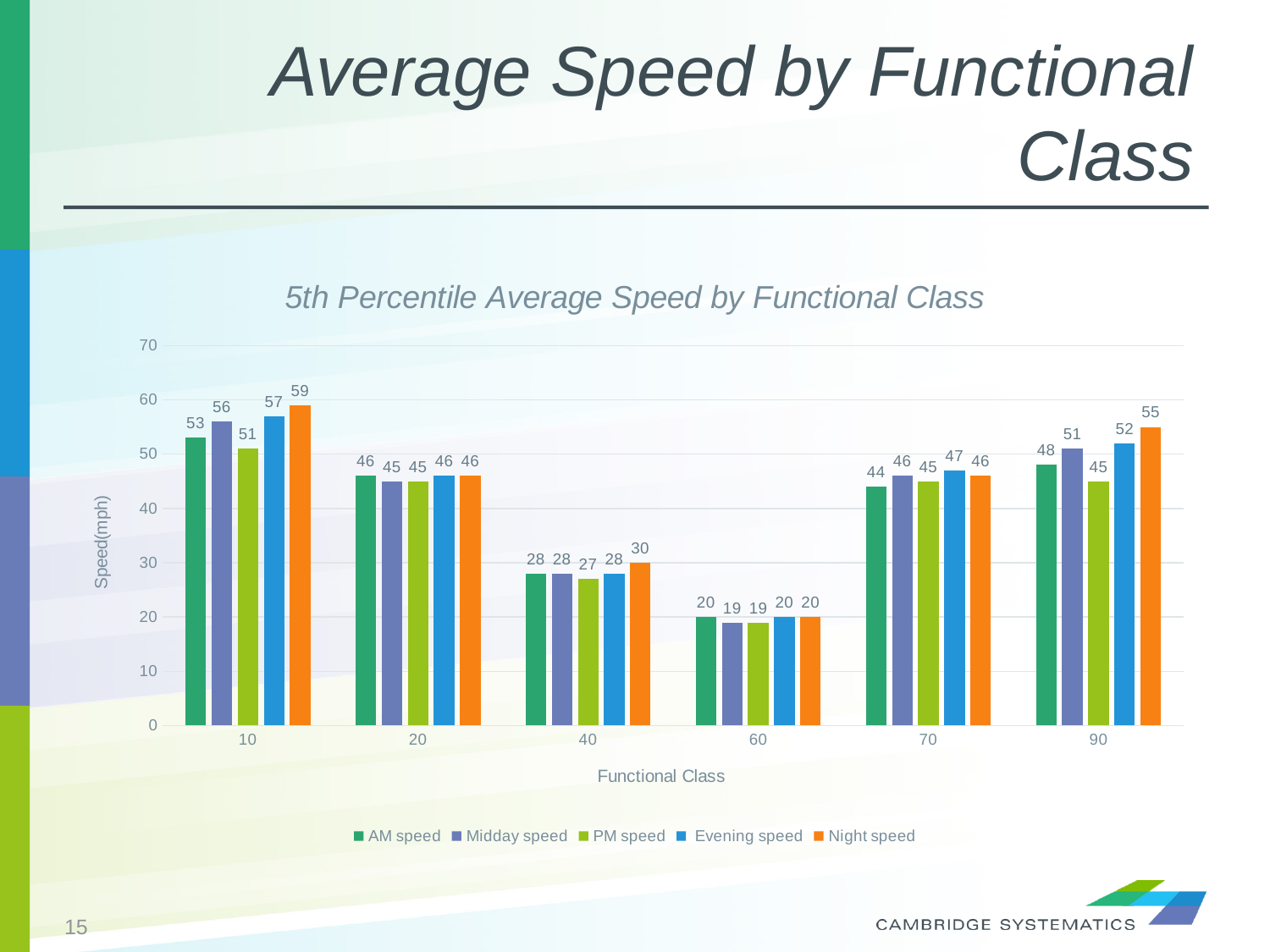
How many functional classes are shown on the x axis? 6 What kind of chart is shown on the slide? Bar chart What is the difference between the Night speed and the PM speed for functional class 90? 10 What is the Evening speed for functional class 70? 47 What is the Night speed for functional class 10? 59 Which functional class has the highest Night speed? 10 What is the title of the chart? 5th Percentile Average Speed by Functional Class Which is larger, the Midday speed for functional class 10 or the Midday speed for functional class 90? Midday speed for functional class 10 What is the PM speed for functional class 90? 45 How many series does the legend list? 5 Which functional class has the lowest AM speed? 60 What is the label of the y axis? Speed(mph)